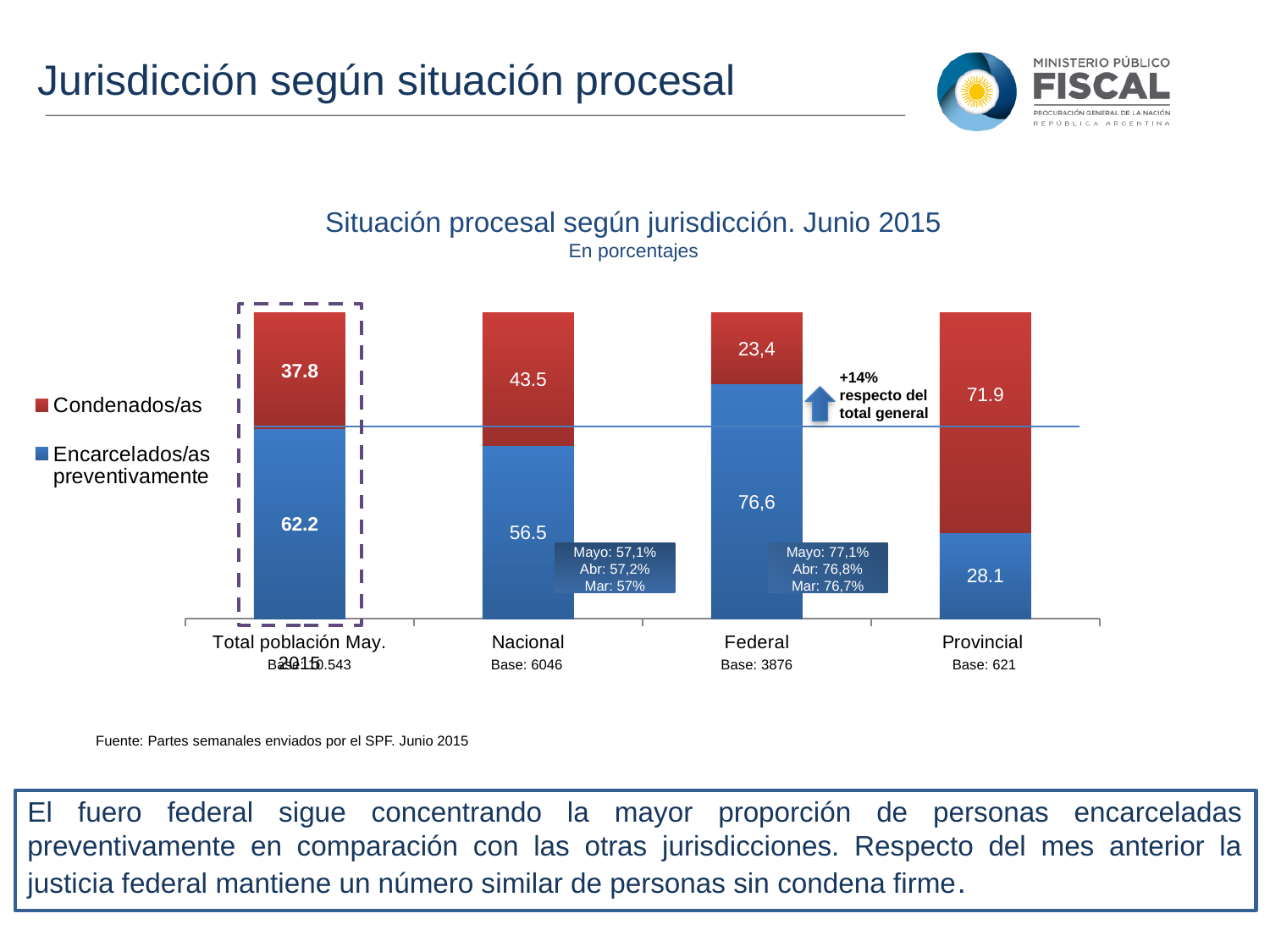
What is the title of the chart? Situación procesal según jurisdicción. Junio 2015 Which category has the lowest value for Condenados/as? Federal Which category has the highest value for Encarcelados/as preventivamente? Federal How many series does the legend list? 2 What is the value for Condenados/as in the Provincial category? 71.9 What is the value for Encarcelados/as preventivamente in the Federal category? 76,6 How many categories are shown on the x axis? 4 What is the difference between the Condenados/as values for Provincial and Nacional? 28.4 What is the value for Encarcelados/as preventivamente in the Nacional category? 56.5 What kind of chart is shown on the slide? Stacked bar chart What is the value for Condenados/as in the Total población May. 2015 category? 37.8 Which is larger: Encarcelados/as preventivamente for Nacional or for Provincial? Nacional